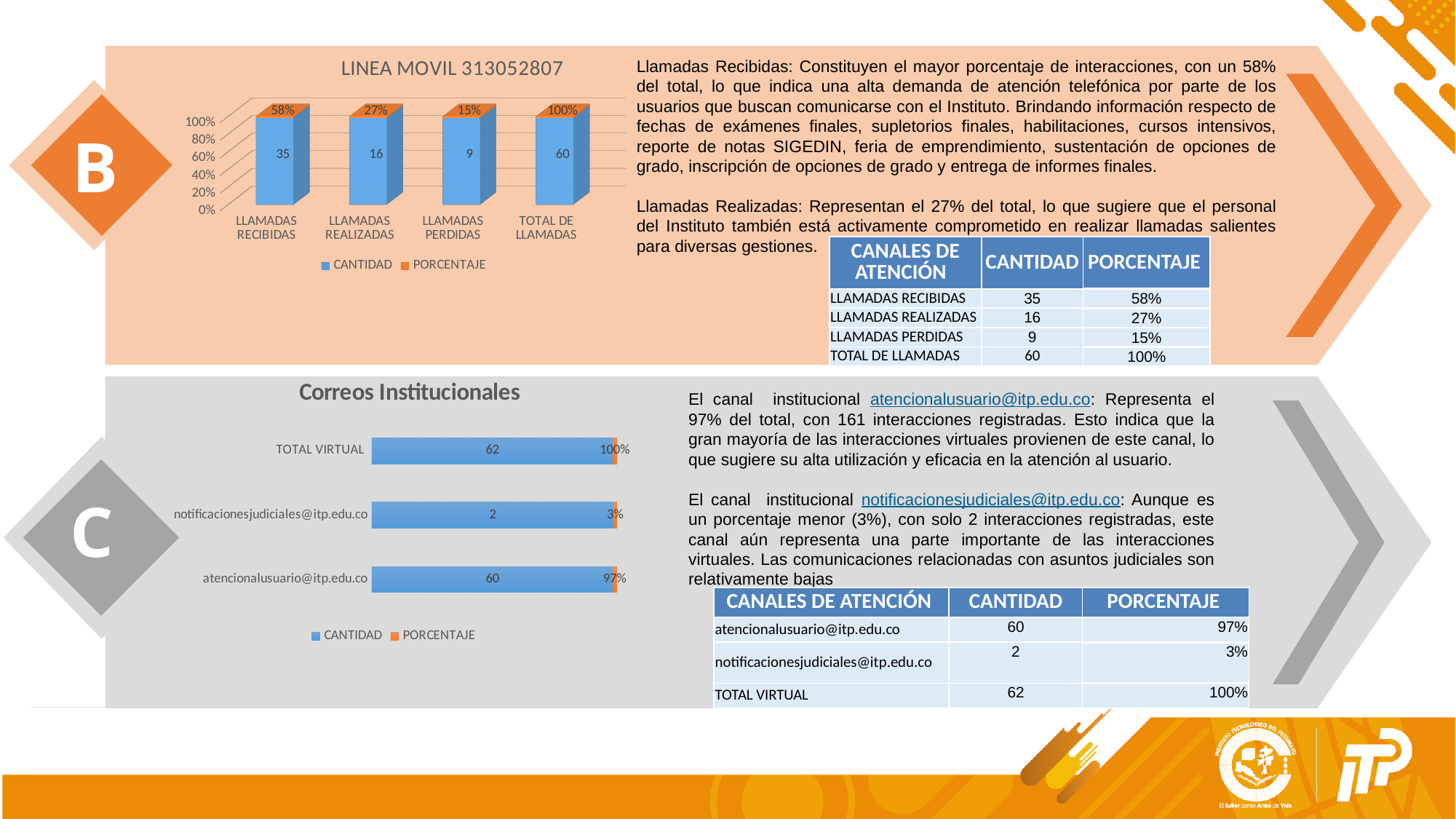
In the Correos Institucionales chart, which of atencionalusuario@itp.edu.co or notificacionesjudiciales@itp.edu.co has the larger CANTIDAD? atencionalusuario@itp.edu.co In the LINEA MOVIL 313052807 chart, what PORCENTAJE is shown for LLAMADAS PERDIDAS? 15% In the Correos Institucionales chart, what PORCENTAJE is shown for atencionalusuario@itp.edu.co? 97% In the Correos Institucionales chart, what is the difference in CANTIDAD between TOTAL VIRTUAL and atencionalusuario@itp.edu.co? 2 What kind of chart is the Correos Institucionales chart? Bar chart In the LINEA MOVIL 313052807 chart, which category has the lowest CANTIDAD value? LLAMADAS PERDIDAS In the Correos Institucionales chart, what is the CANTIDAD value for notificacionesjudiciales@itp.edu.co? 2 In the LINEA MOVIL 313052807 chart, what is the CANTIDAD value for LLAMADAS RECIBIDAS? 35 In the LINEA MOVIL 313052807 chart, how many categories are shown on the x axis? 4 In the LINEA MOVIL 313052807 chart, how many series does the legend list? 2 In the Correos Institucionales chart, what colour represents the CANTIDAD series in the legend? Blue In the LINEA MOVIL 313052807 chart, what is the difference in CANTIDAD between LLAMADAS RECIBIDAS and LLAMADAS REALIZADAS? 19